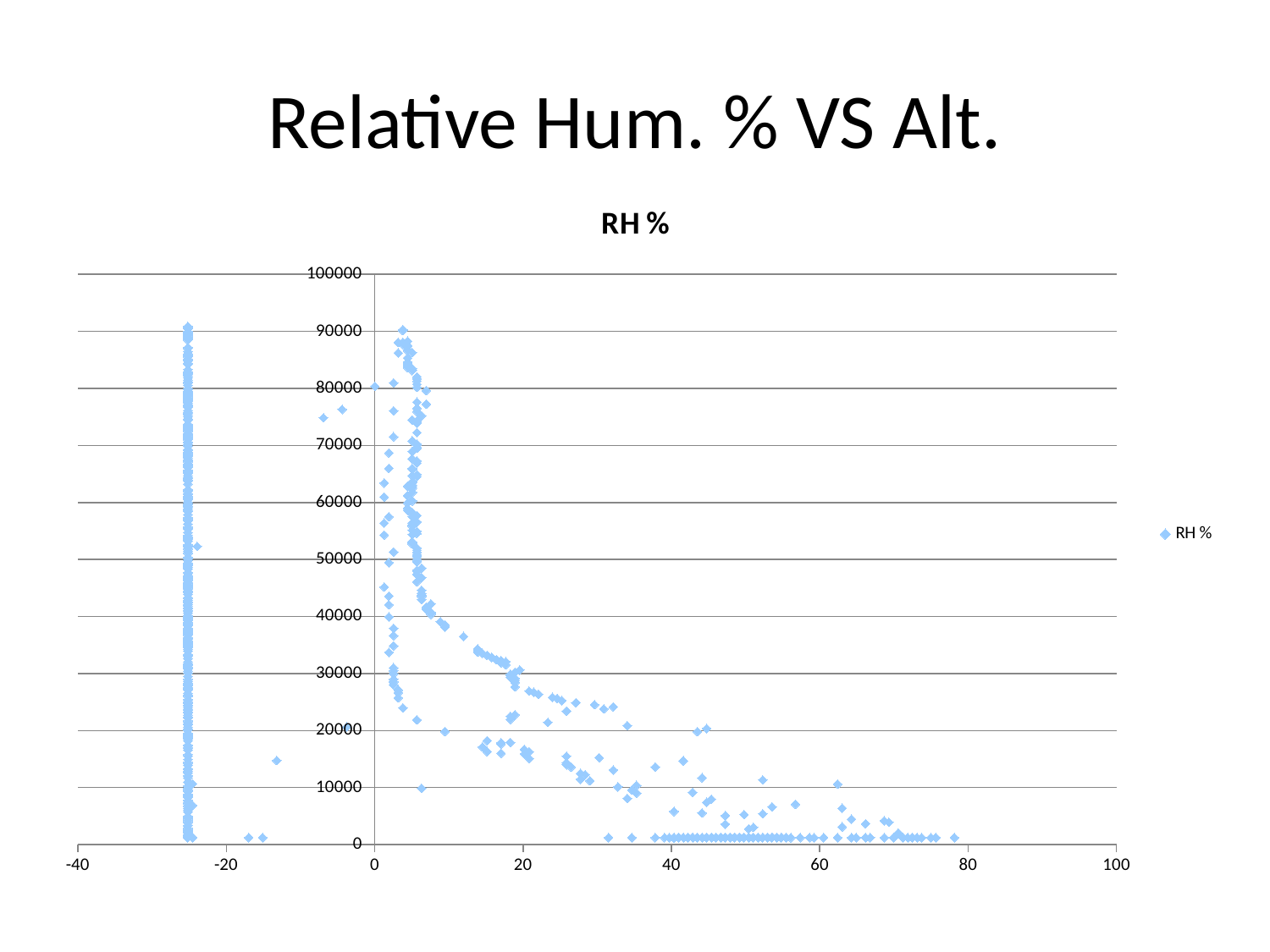
Is the x value of the vertical column of points on the far left of the chart greater or less than -20? less Is the largest x value reached by any point greater or less than 90? less How many series does the legend list? 1 Is the y value of the topmost point in the cluster near x = 0 greater or less than 80000? greater What kind of chart is shown on the slide? scatter chart What is the name of the series shown in the legend? RH % What is the title of the chart? RH %